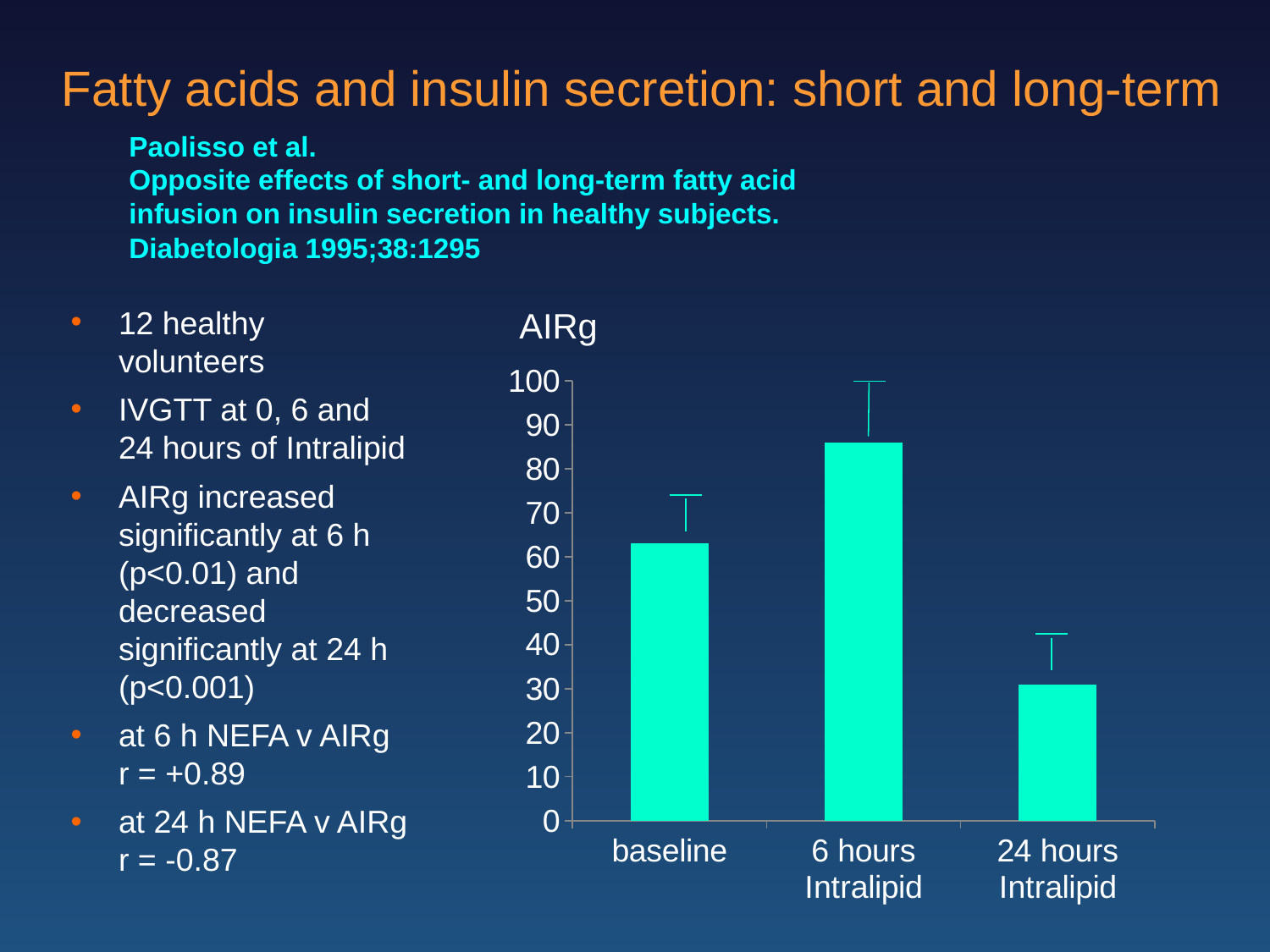
Is the AIRg value for baseline greater or less than 60? greater Which is larger, the AIRg value at baseline or at 24 hours Intralipid? baseline Is the AIRg value for baseline greater or less than 70? less Is the AIRg value for 6 hours Intralipid greater or less than 80? greater Which category has the lowest AIRg value? 24 hours Intralipid Does the AIRg value rise or fall from 6 hours Intralipid to 24 hours Intralipid? fall How many bars (categories) does the chart show? 3 Which category has the highest AIRg value? 6 hours Intralipid What kind of chart is shown on the slide? bar chart What is the title of the chart? AIRg